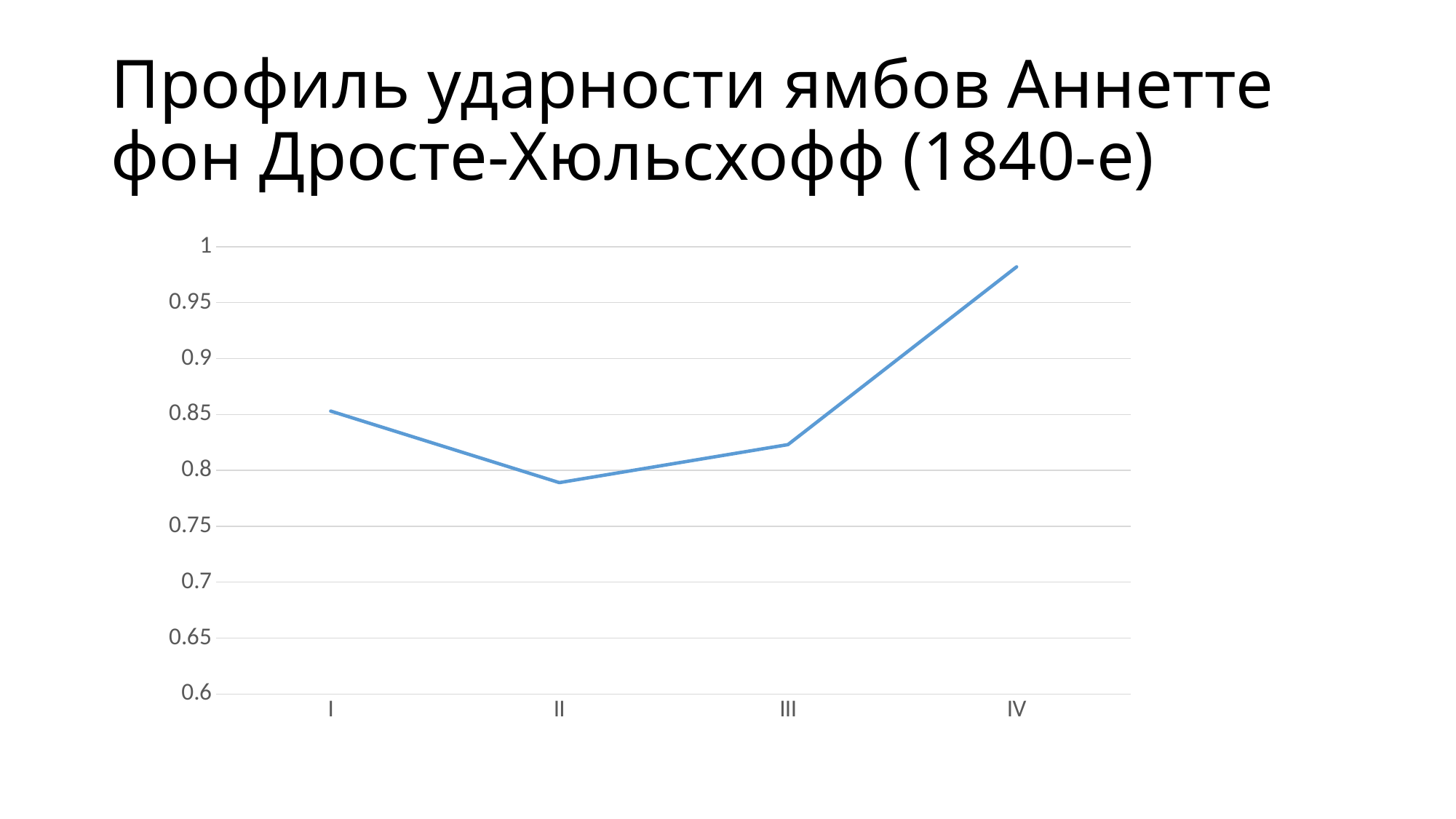
What is the title of the slide? Профиль ударности ямбов Аннетте фон Дросте-Хюльсхофф (1840-е) Is the value for II greater or less than 0.8? less Which is larger, the value for I or the value for II? I Does the line rise or fall from I to II? fall Does the line rise or fall from III to IV? rise Which category has the lowest value? II How many points are plotted along the x axis? 4 Which is larger, the value for III or the value for IV? IV Which category has the highest value? IV Is the value for IV greater or less than 0.95? greater What kind of chart is shown on the slide? line chart Is the value for I greater or less than 0.9? less